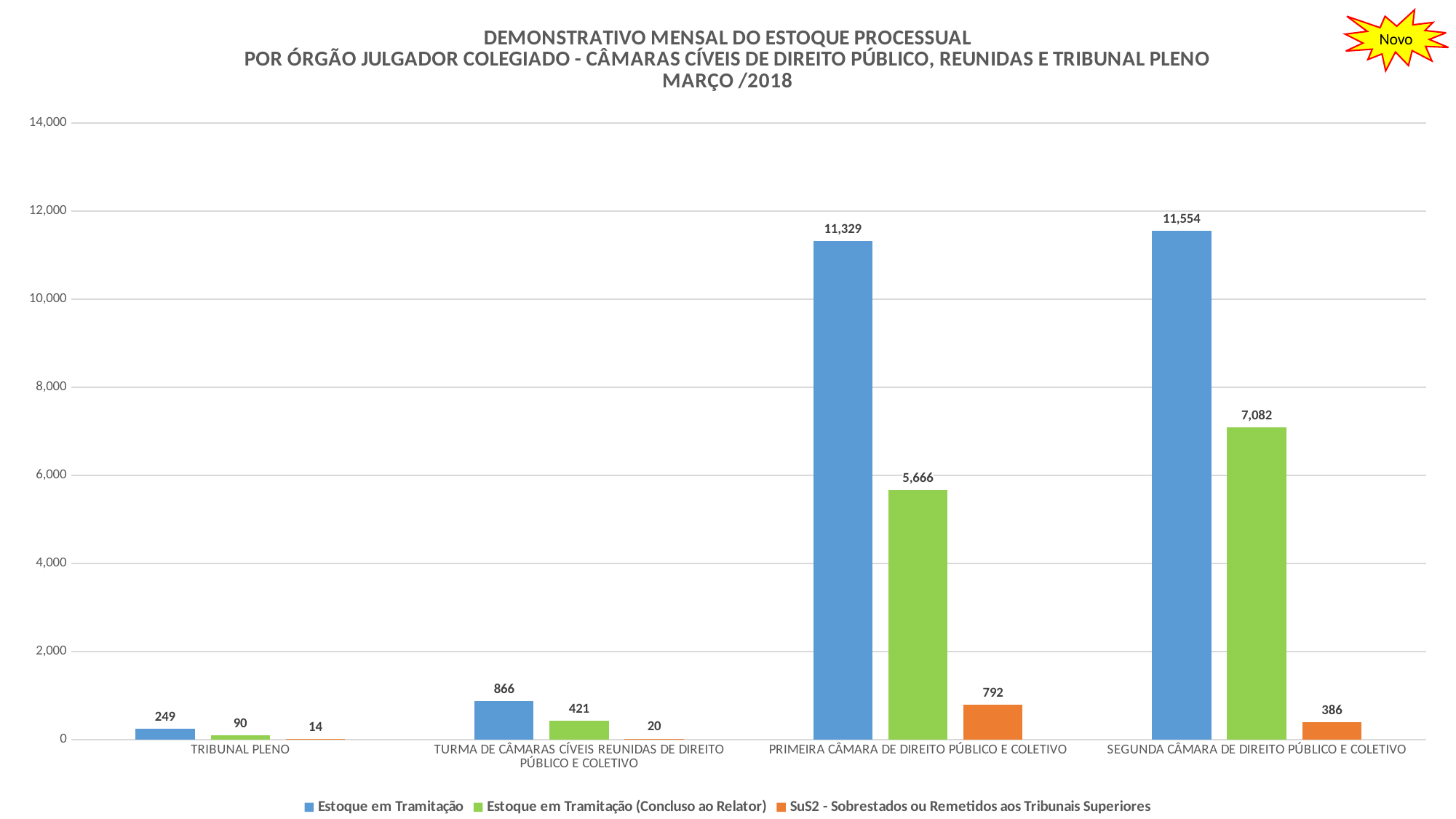
What is the value of Estoque em Tramitação (Concluso ao Relator) for SEGUNDA CÂMARA DE DIREITO PÚBLICO E COLETIVO? 7,082 What is the value of SuS2 - Sobrestados ou Remetidos aos Tribunais Superiores for TURMA DE CÂMARAS CÍVEIS REUNIDAS DE DIREITO PÚBLICO E COLETIVO? 20 Which is larger: the SuS2 value for PRIMEIRA CÂMARA DE DIREITO PÚBLICO E COLETIVO or for SEGUNDA CÂMARA DE DIREITO PÚBLICO E COLETIVO? PRIMEIRA CÂMARA DE DIREITO PÚBLICO E COLETIVO Which category has the highest value for Estoque em Tramitação? SEGUNDA CÂMARA DE DIREITO PÚBLICO E COLETIVO How many series does the legend list? 3 What is the value of Estoque em Tramitação for PRIMEIRA CÂMARA DE DIREITO PÚBLICO E COLETIVO? 11,329 Is the Estoque em Tramitação (Concluso ao Relator) value for PRIMEIRA CÂMARA DE DIREITO PÚBLICO E COLETIVO greater or less than 6,000? less Which month and year does the chart title refer to? MARÇO /2018 What kind of chart is shown on the slide? Bar chart What is the difference between the Estoque em Tramitação values for SEGUNDA CÂMARA and PRIMEIRA CÂMARA DE DIREITO PÚBLICO E COLETIVO? 225 How many categories are shown on the x axis? 4 Which category has the lowest value for Estoque em Tramitação (Concluso ao Relator)? TRIBUNAL PLENO